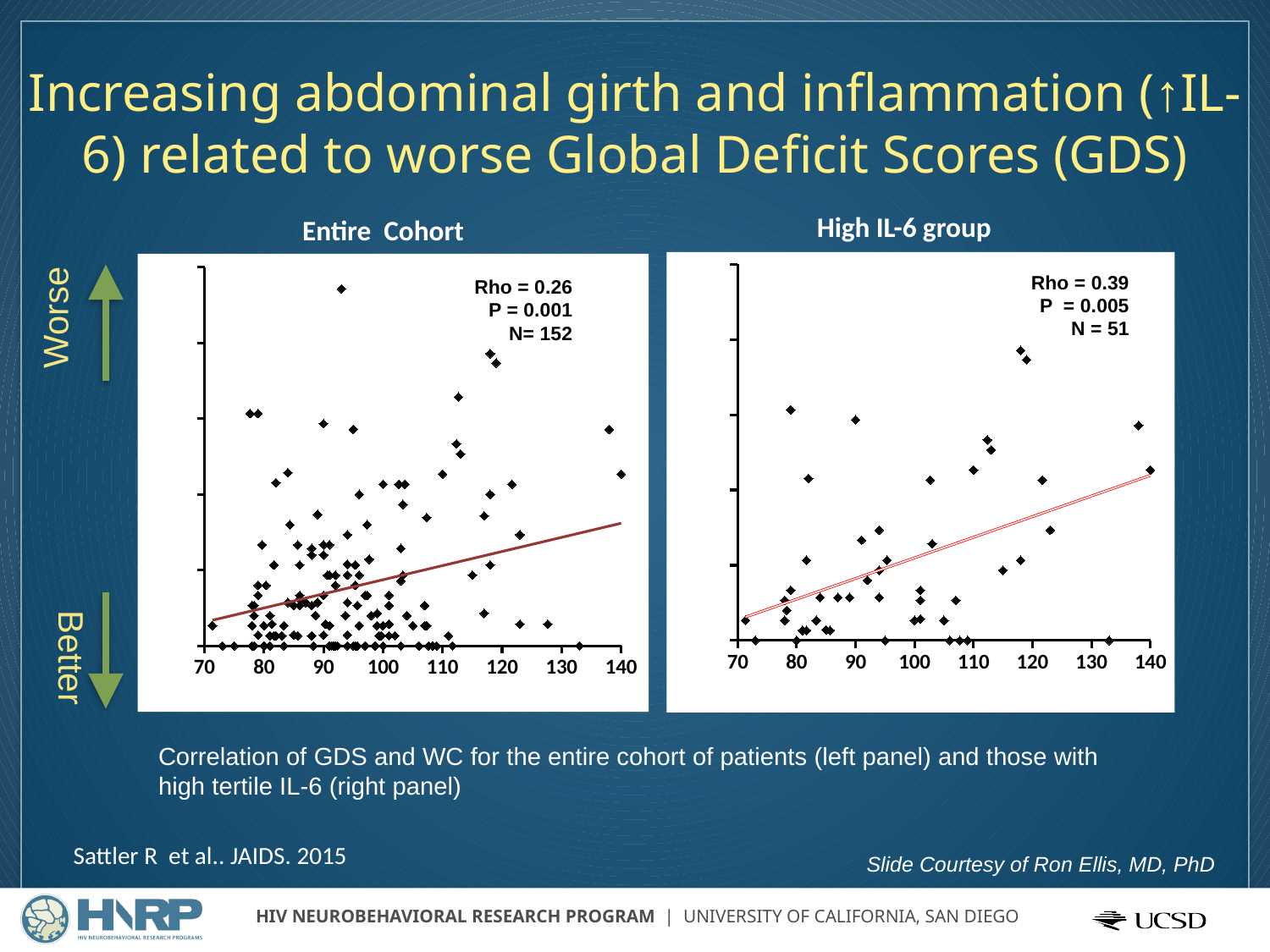
How many more participants (N) are in the "Entire Cohort" chart than in the "High IL-6 group" chart? 101 In the "High IL-6 group" chart, does the fitted line rise or fall as the x-axis value increases? rise In the "Entire Cohort" chart, what is the highest value labelled on the x axis? 140 In the "Entire Cohort" chart, what is the P value printed on the chart? 0.001 What kind of chart is the "Entire Cohort" chart? scatter plot Which chart reports the larger Rho value, "Entire Cohort" or "High IL-6 group"? High IL-6 group In the "High IL-6 group" chart, what is the Rho value printed on the chart? 0.39 In the "High IL-6 group" chart, what is the P value printed on the chart? 0.005 How many scatter plots are shown on the slide? 2 In the "Entire Cohort" chart, what is the Rho value printed on the chart? 0.26 In the "Entire Cohort" chart, what is the N printed on the chart? 152 In the "High IL-6 group" chart, what is the N printed on the chart? 51